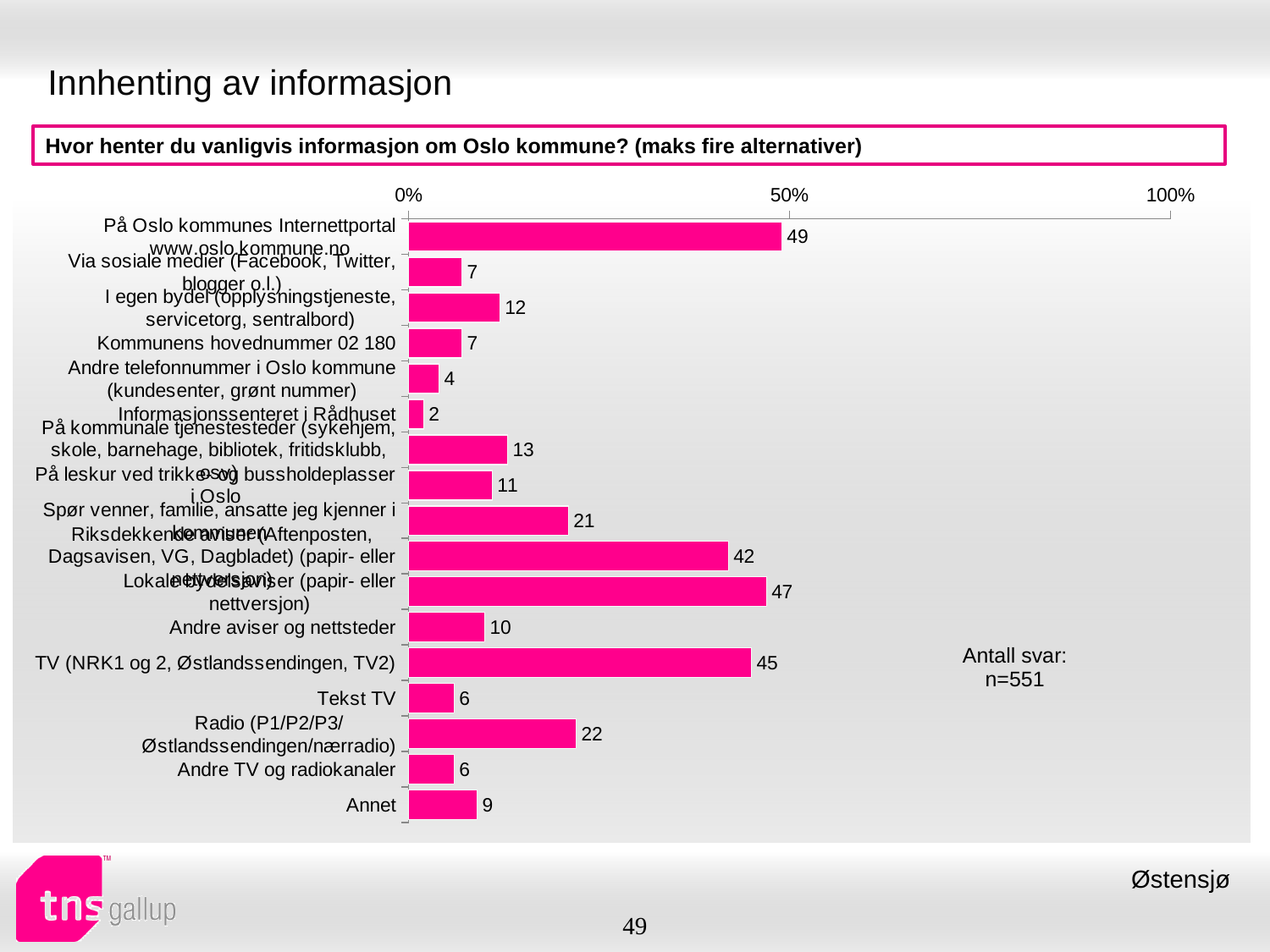
Which is larger: the value for "Tekst TV" or the value for "Andre aviser og nettsteder"? Andre aviser og nettsteder What is the difference between the values for "Lokale bydelsaviser (papir- eller nettversjon)" and "Riksdekkende aviser (Aftenposten, Dagsavisen, VG, Dagbladet) (papir- eller nettversjon)"? 5 What value is shown for "Kommunens hovednummer 02 180"? 7 Which category has the highest value? På Oslo kommunes Internettportal www.oslo.kommune.no What is the number of respondents (n) stated on the slide? n=551 What value is shown for "Annet"? 9 Is the value for "På Oslo kommunes Internettportal www.oslo.kommune.no" greater or less than 50%? less What kind of chart is shown on the slide? bar chart Which category has the lowest value? Informasjonssenteret i Rådhuset How many categories are shown in the chart? 17 What value is shown for "Radio (P1/P2/P3/Østlandssendingen/nærradio)"? 22 What value is shown for "TV (NRK1 og 2, Østlandssendingen, TV2)"? 45